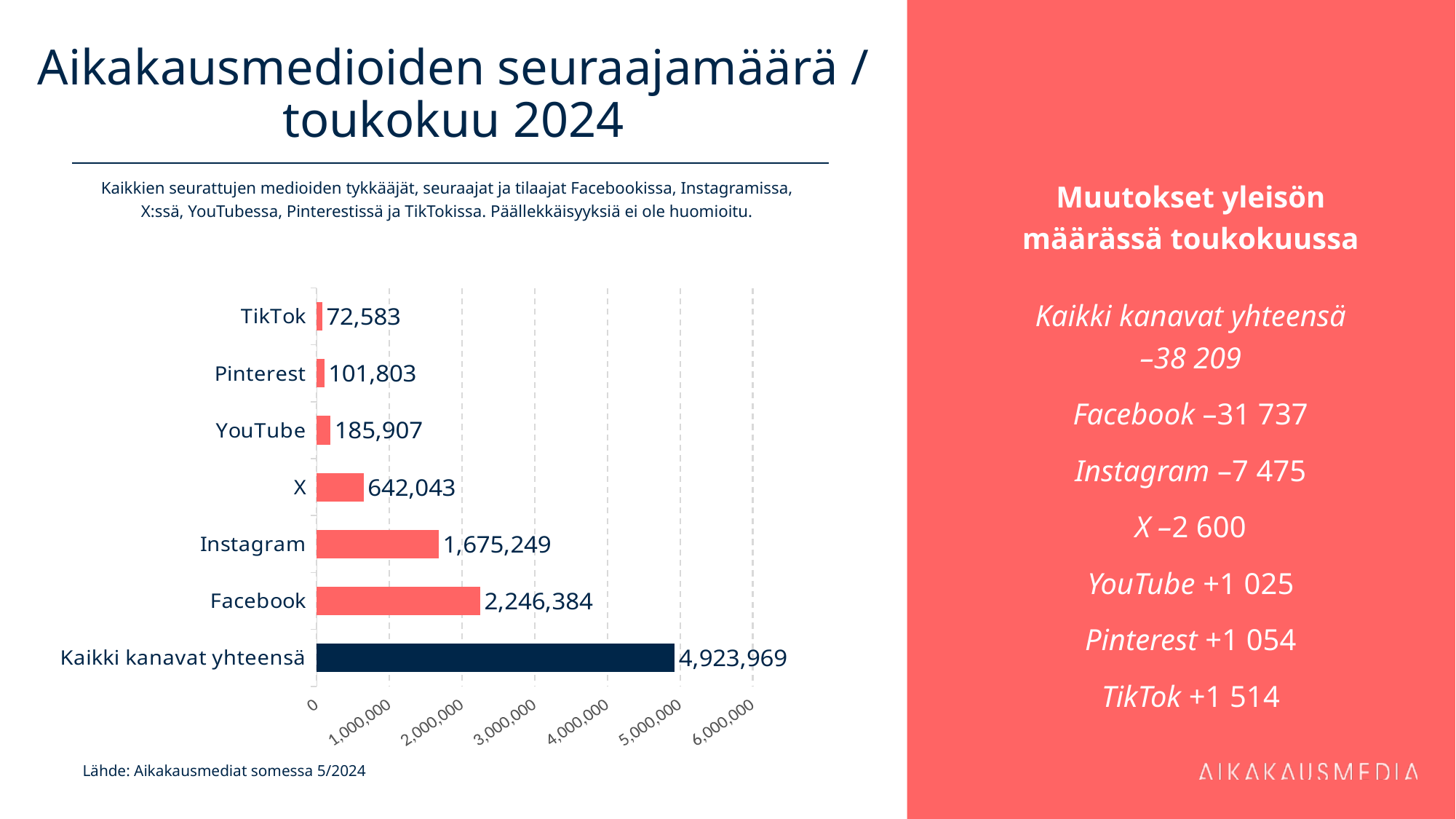
Which category has the highest value? Kaikki kanavat yhteensä Is the value for X greater or less than 1,000,000? less What kind of chart is shown on the slide? bar chart What is the difference between the values for Facebook and Instagram? 571,135 What is the value for Facebook? 2,246,384 What is the difference between the values for YouTube and Pinterest? 84,104 What is the value for X? 642,043 What is the value for TikTok? 72,583 Which is larger, the value for Pinterest or the value for YouTube? YouTube What is the value for Kaikki kanavat yhteensä? 4,923,969 How many categories are shown in the chart? 7 Which category has the lowest value? TikTok